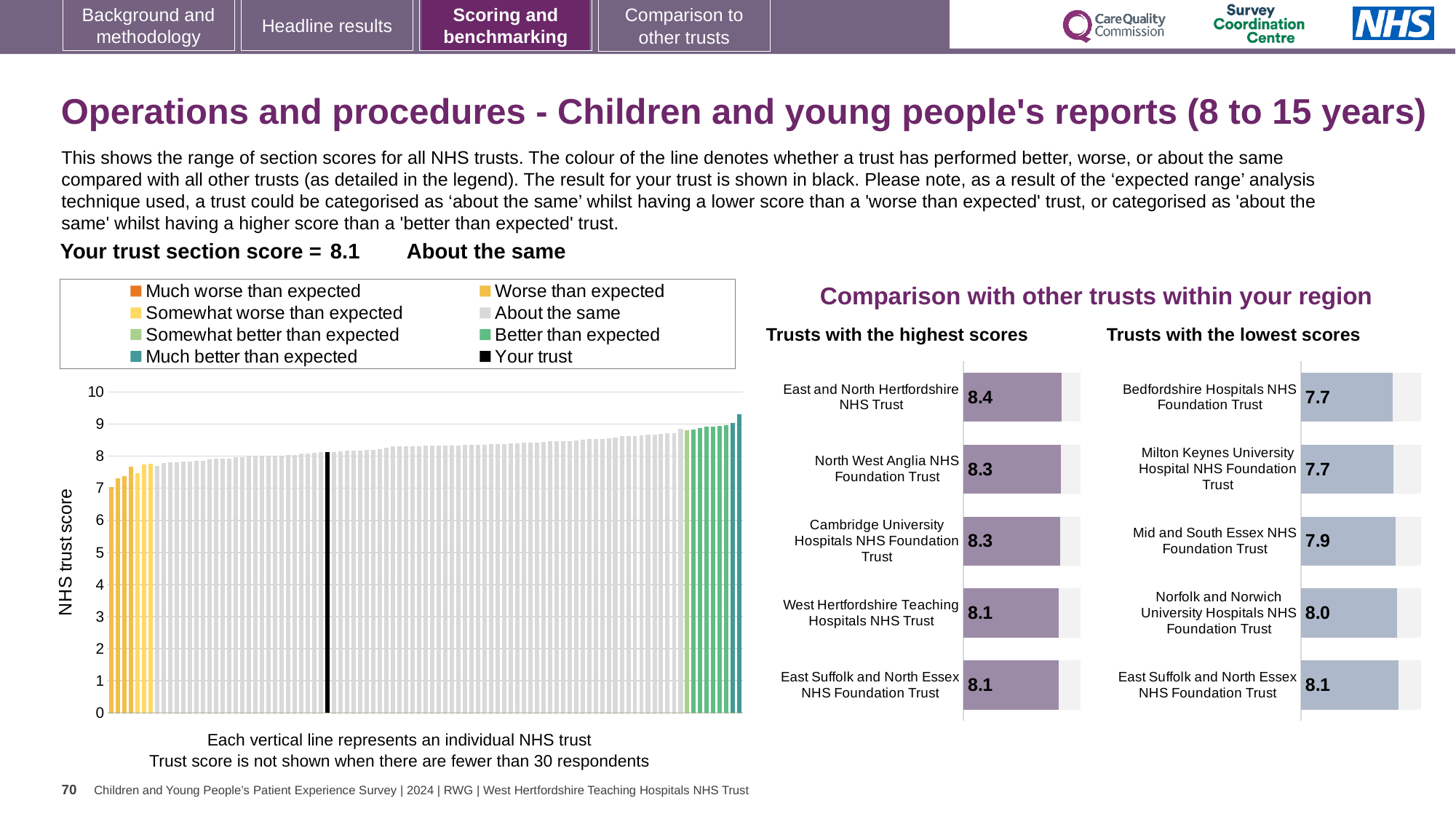
In the 'Trusts with the lowest scores' chart, what is the score for Mid and South Essex NHS Foundation Trust? 7.9 In the 'Trusts with the highest scores' chart, what is the score for East and North Hertfordshire NHS Trust? 8.4 In the large chart on the left showing all NHS trusts, do the bar values rise or fall from left to right? rise In the large chart on the left showing all NHS trusts, is the value of the leftmost (lowest) bar greater or less than 8? less In the 'Trusts with the lowest scores' chart, what is the difference between the scores of East Suffolk and North Essex NHS Foundation Trust and Bedfordshire Hospitals NHS Foundation Trust? 0.4 How many entries does the legend above the large chart on the left list? 8 In the 'Trusts with the highest scores' chart, what is the difference between the scores of East and North Hertfordshire NHS Trust and West Hertfordshire Teaching Hospitals NHS Trust? 0.3 In the 'Trusts with the highest scores' chart, how many trusts are listed? 5 In the 'Trusts with the highest scores' chart, which trust has the highest score? East and North Hertfordshire NHS Trust In the large chart on the left showing all NHS trusts, what is the section score for your trust (the black bar)? 8.1 In the 'Trusts with the lowest scores' chart, which trust has the highest score? East Suffolk and North Essex NHS Foundation Trust In the 'Trusts with the lowest scores' chart, which has the larger score: Mid and South Essex NHS Foundation Trust or Norfolk and Norwich University Hospitals NHS Foundation Trust? Norfolk and Norwich University Hospitals NHS Foundation Trust